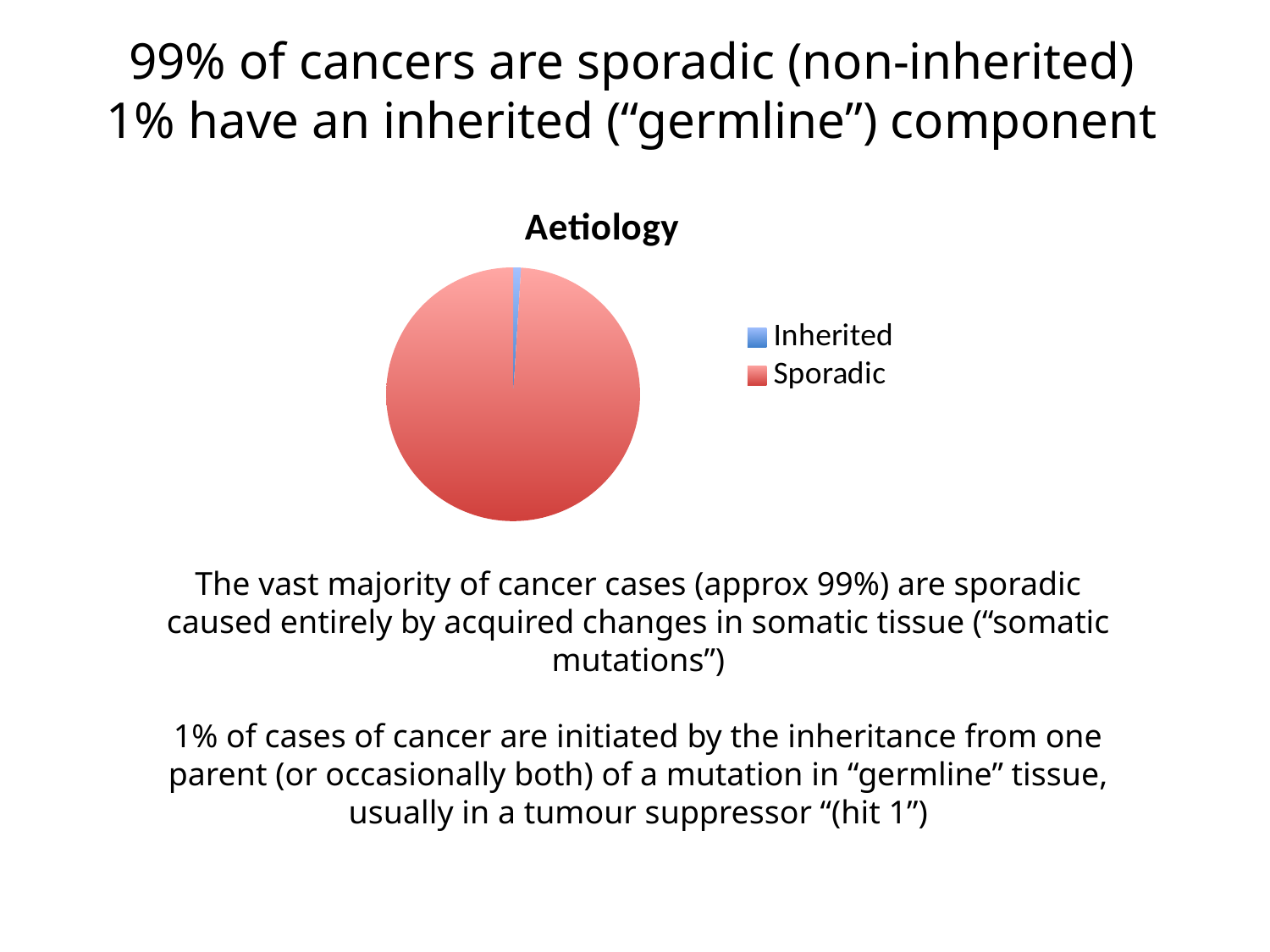
What kind of chart is shown under the title "Aetiology"? pie chart Which category has the largest slice of the pie? Sporadic How many slices does the pie chart have? 2 What is the title of the chart? Aetiology Which slice is larger, Inherited or Sporadic? Sporadic Which category is shown in blue in the legend? Inherited How many entries does the chart legend list? 2 Which category has the smallest slice of the pie? Inherited What colour is the Sporadic slice in the pie chart? red